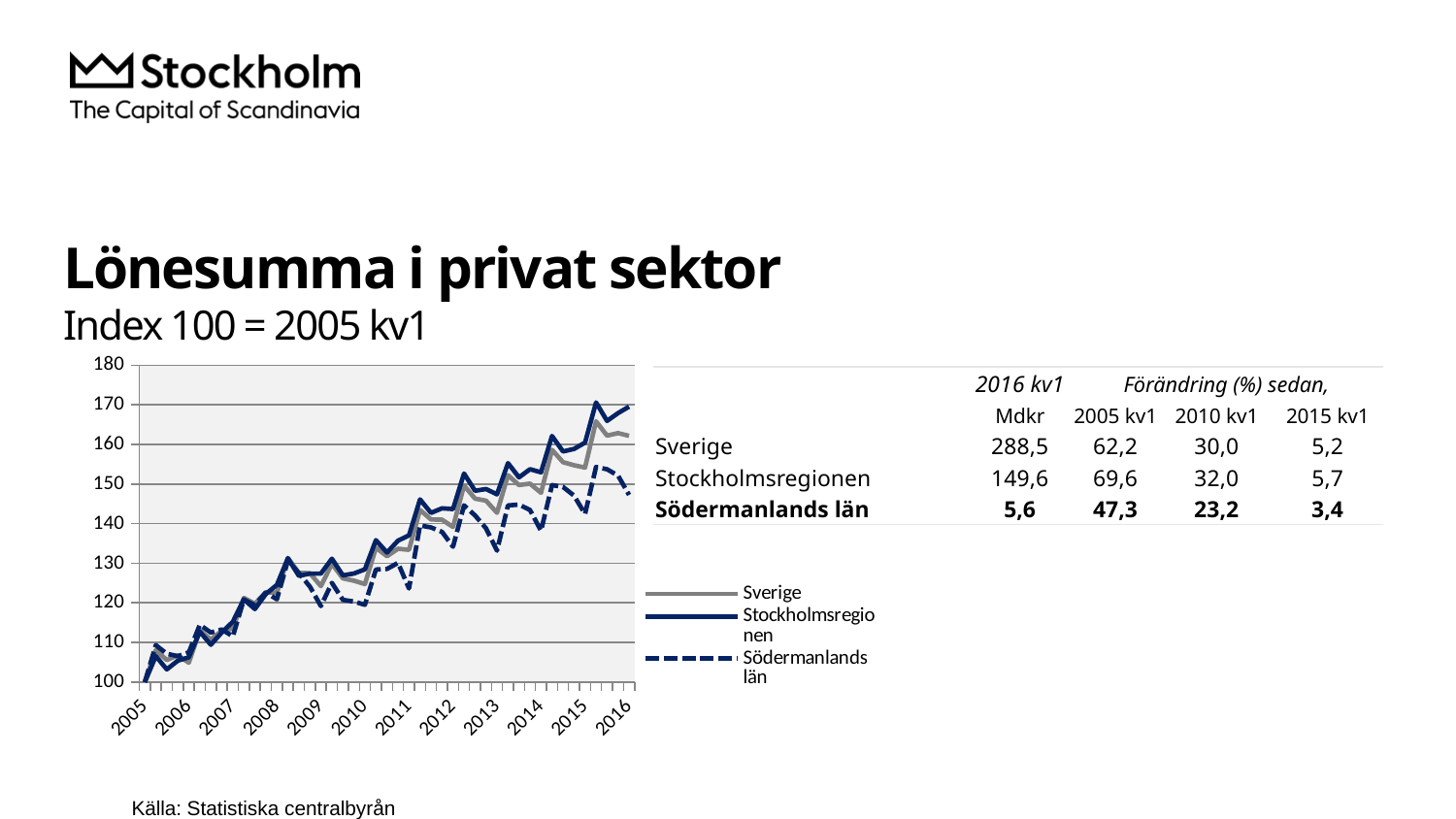
How many years are labelled on the x axis of the chart? 12 Which series are listed in the chart's legend? Sverige, Stockholmsregionen, Södermanlands län What is the title of the chart? Lönesumma i privat sektor Which series has the highest value at the end of the chart in 2016? Stockholmsregionen Is the value for Sverige at the end of 2016 greater or less than 150? greater What is the index value for all series at 2005 kv1? 100 What kind of chart is shown on the slide? line chart Is the value for Södermanlands län at the end of 2016 greater or less than 160? less Which series has the lowest value at the end of the chart in 2016? Södermanlands län How many series does the chart's legend list? 3 Do the values in the chart generally rise or fall from 2005 to 2016? rise Is the value for Stockholmsregionen at the end of 2016 greater or less than 160? greater